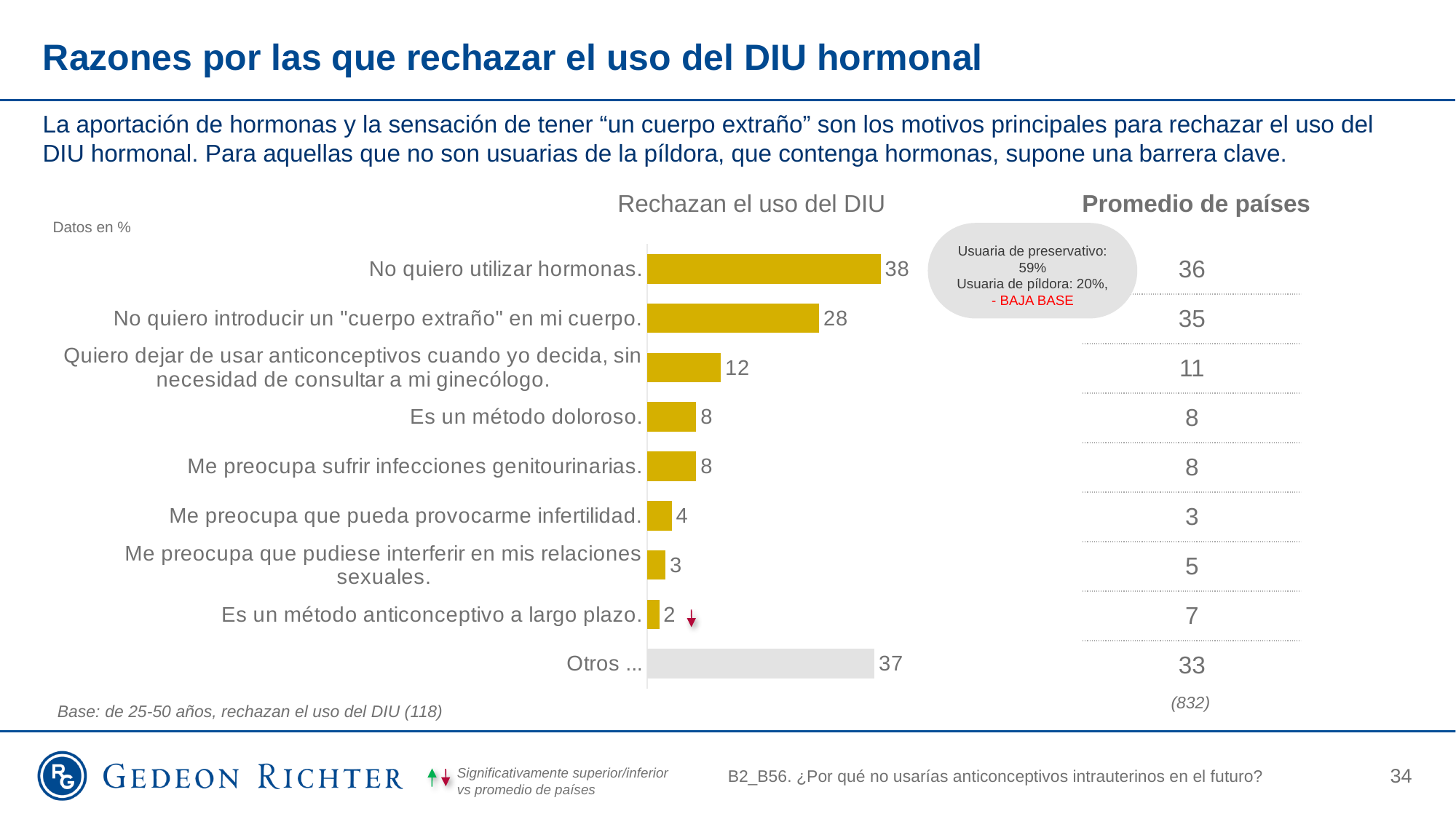
How many categories are shown in the bar chart? 9 What is the Promedio de países value shown for "No quiero utilizar hormonas."? 36 What is the value for "Es un método anticonceptivo a largo plazo."? 2 Which category has the highest value in the chart? No quiero utilizar hormonas. What is the title of the chart? Rechazan el uso del DIU What is the value for "No quiero introducir un "cuerpo extraño" en mi cuerpo."? 28 What is the difference between the values for "No quiero utilizar hormonas." and "No quiero introducir un "cuerpo extraño" en mi cuerpo."? 10 What kind of chart is shown on the slide? Bar chart What is the value for "No quiero utilizar hormonas." in the Rechazan el uso del DIU chart? 38 Which is larger: the value for "Me preocupa que pueda provocarme infertilidad." or for "Me preocupa que pudiese interferir en mis relaciones sexuales."? Me preocupa que pueda provocarme infertilidad. What is the value for "Otros ..."? 37 Which category has the lowest value in the chart? Es un método anticonceptivo a largo plazo.